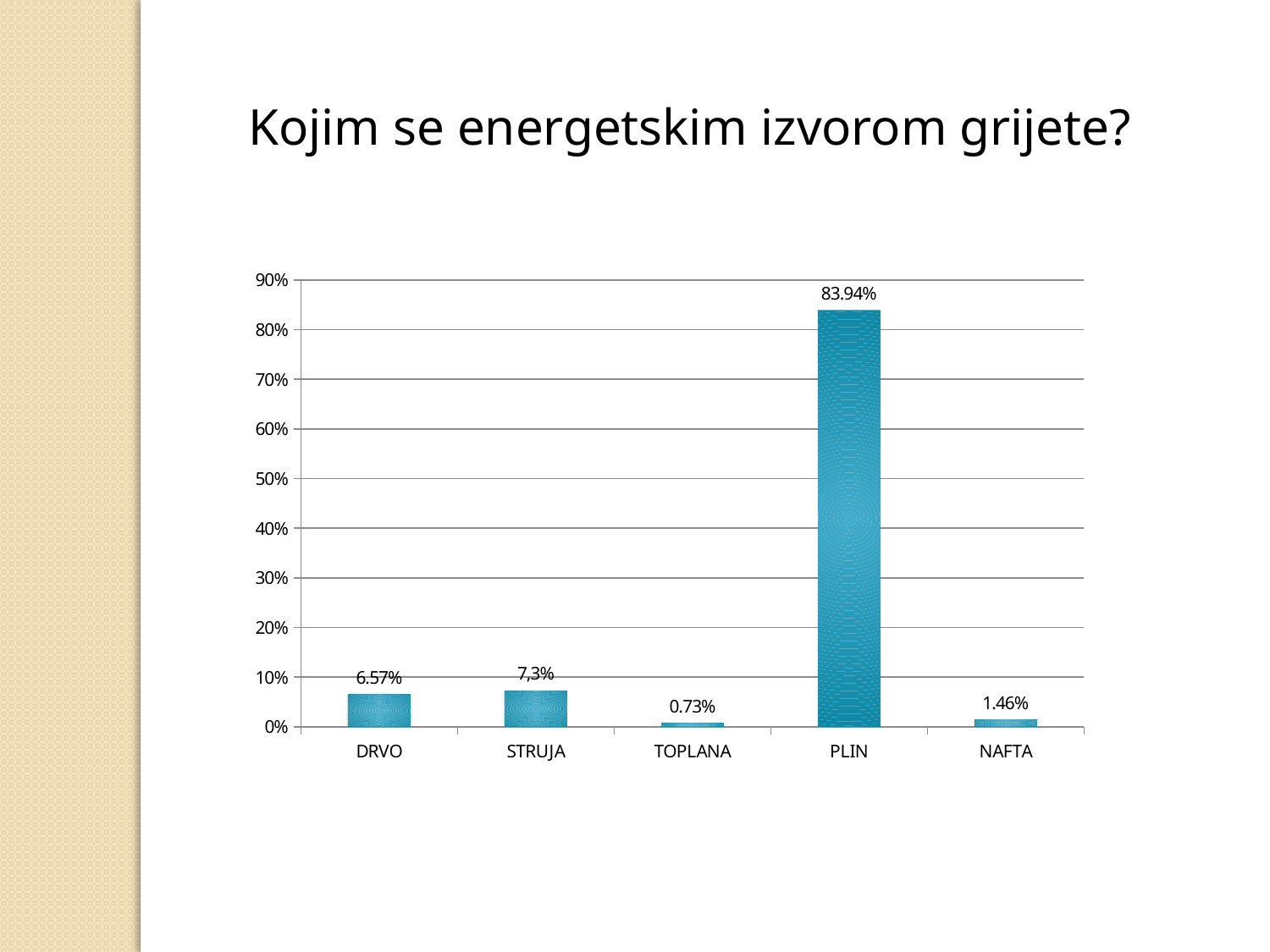
Which category has the highest value? PLIN What is the value for TOPLANA? 0.73% What is the value for PLIN? 83.94% What is the value for NAFTA? 1.46% How many categories are shown on the x axis? 5 Which category has the lowest value? TOPLANA What is the value for DRVO? 6.57% Which is larger, the value for DRVO or the value for NAFTA? DRVO Is the value for PLIN greater or less than 80%? greater What kind of chart is shown on the slide? Bar chart What is the value shown for STRUJA? 7,3% What is the difference between the values for DRVO and NAFTA? 5.11 percentage points